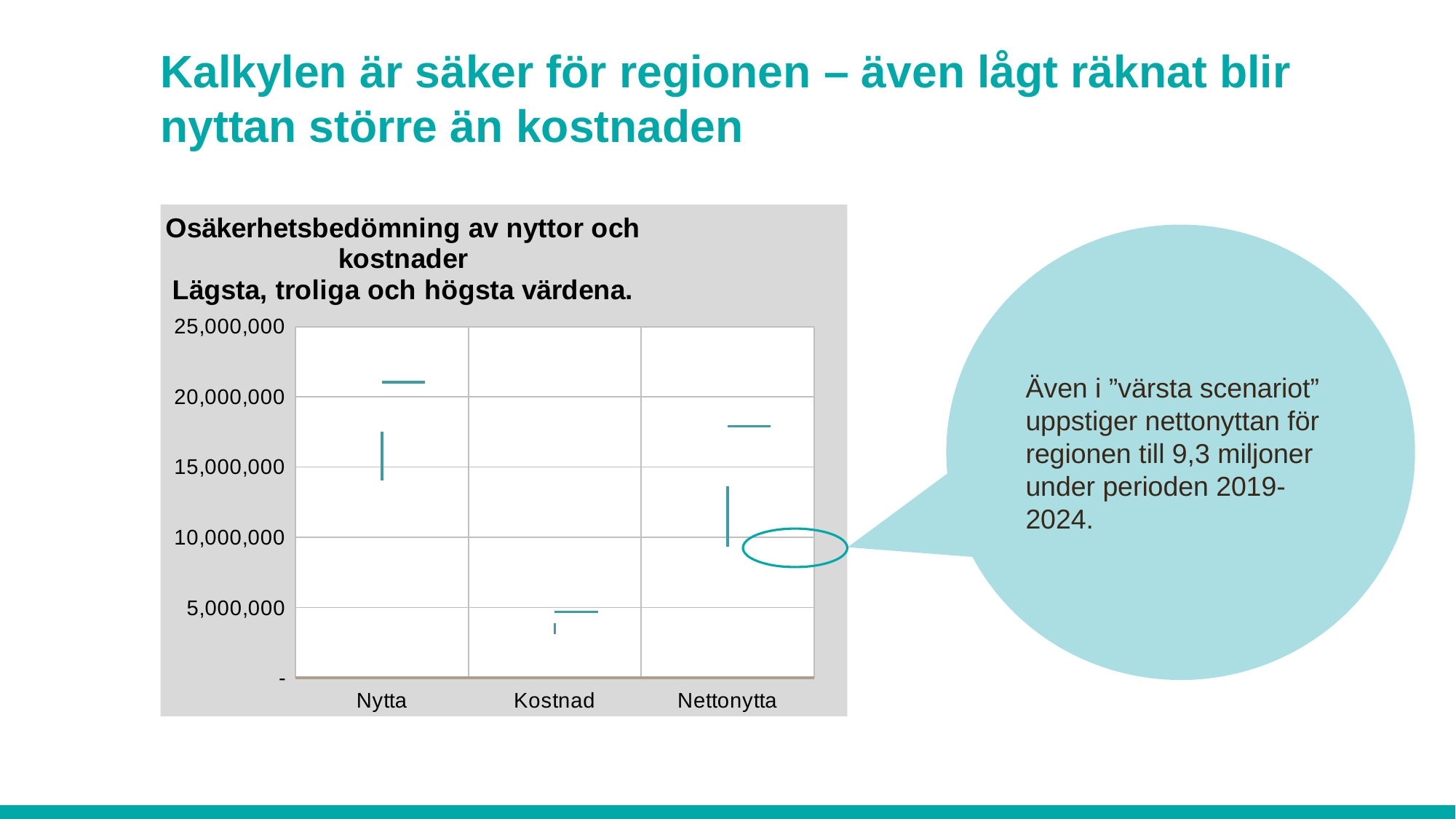
Which category has the highest plotted value in the chart? Nytta What is the highest tick value shown on the y axis of the chart? 25,000,000 Is the highest value for Kostnad greater or less than 5,000,000? less What is the title of the chart? Osäkerhetsbedömning av nyttor och kostnader Lägsta, troliga och högsta värdena. How many categories are shown on the x axis of the chart? 3 Which has larger values, Nytta or Kostnad? Nytta What kind of chart is shown on the slide? stock (high-low) chart Is the lowest value for Nettonytta greater or less than 10,000,000? less Is the lowest value for Nytta greater or less than 15,000,000? less Which category has the lowest plotted values in the chart? Kostnad